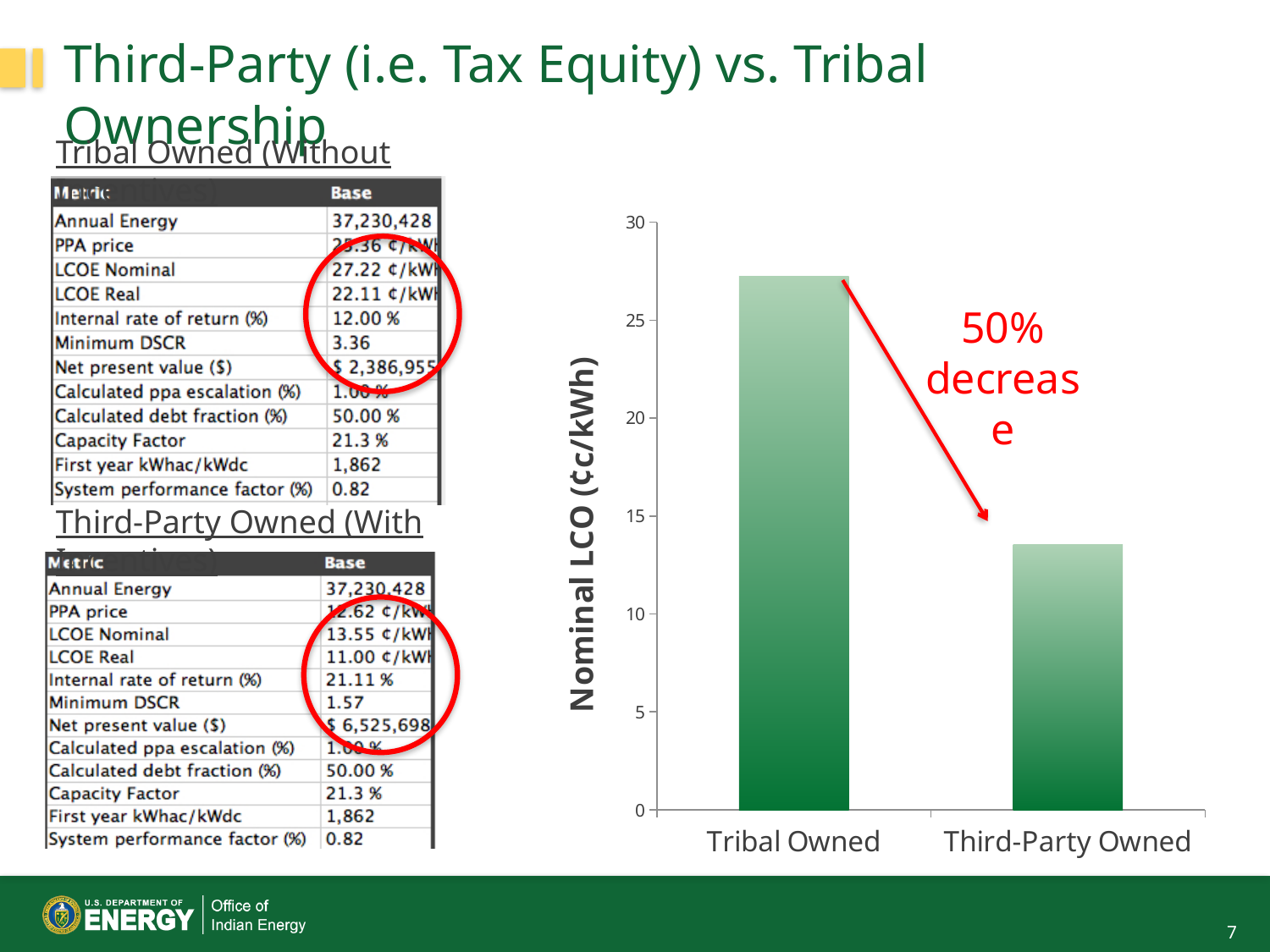
Is the value for Tribal Owned greater or less than 25? greater How many bars are plotted in the chart? 2 Which category has the highest Nominal LCO in the chart? Tribal Owned What does the red annotation next to the arrow on the chart say? 50% decrease What is the label on the vertical axis of the chart? Nominal LCO (¢c/kWh) Is the value for Third-Party Owned greater or less than 15? less What kind of chart is shown on the slide? bar chart Which bar is taller, Tribal Owned or Third-Party Owned? Tribal Owned Which category has the lowest Nominal LCO in the chart? Third-Party Owned Do the bar values rise or fall from left to right across the chart? fall Is the value for Tribal Owned greater or less than 30? less